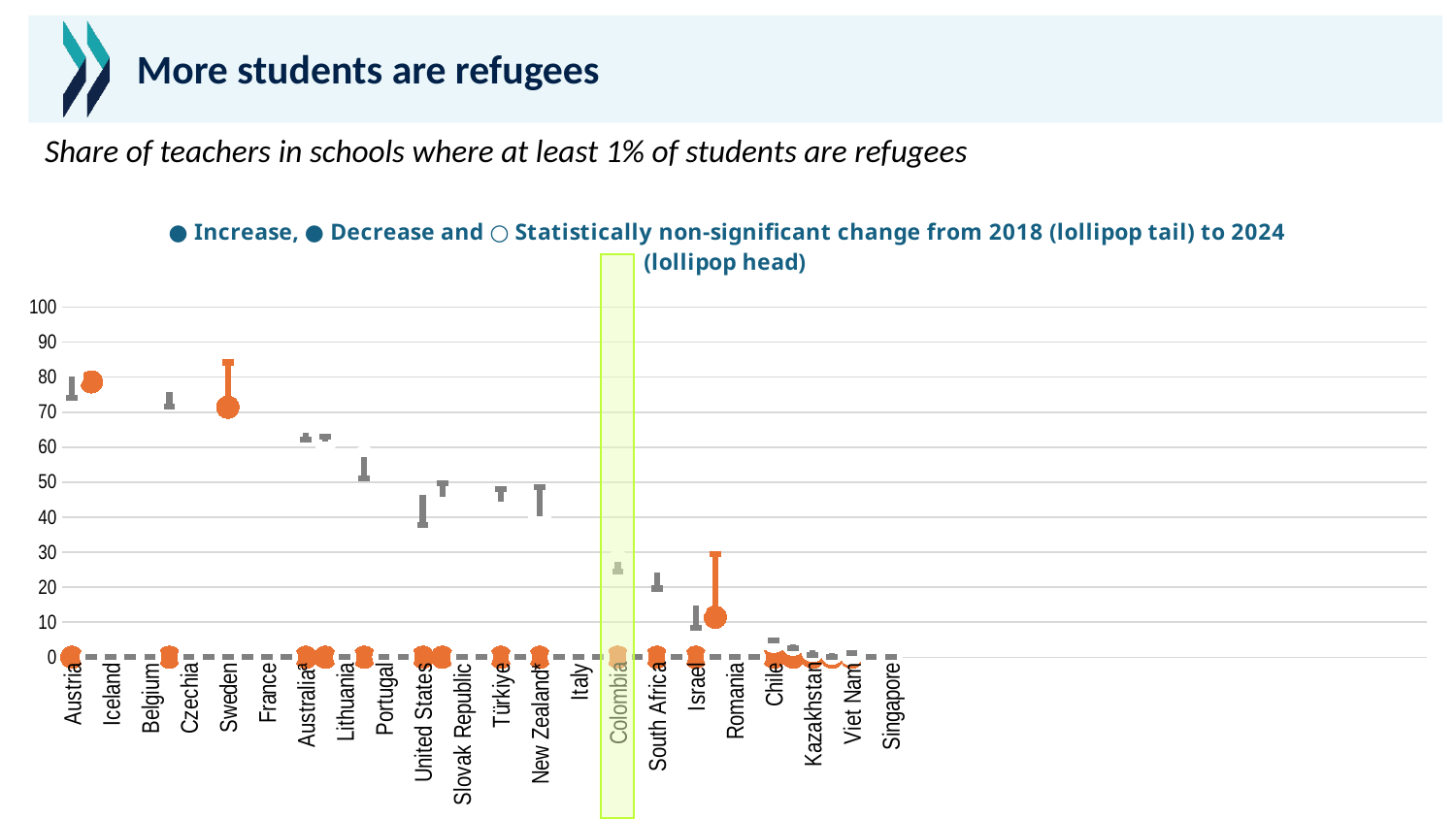
Is the value for Singapore greater or less than 10? less Do the values generally rise or fall moving from left to right along the x axis? fall Which country is highlighted with a shaded box on the chart? Colombia Which has a larger value, Sweden or Colombia? Sweden How many countries are listed along the x axis of the chart? 22 What kind of chart is shown on the slide? lollipop chart Is the 2024 value (lollipop head) for Sweden greater or less than 60? greater Which has a larger value, Colombia or Singapore? Colombia Is the value for Colombia greater or less than 30? less What is the subtitle describing the measure plotted on the chart? Share of teachers in schools where at least 1% of students are refugees What is the highest value shown on the y axis? 100